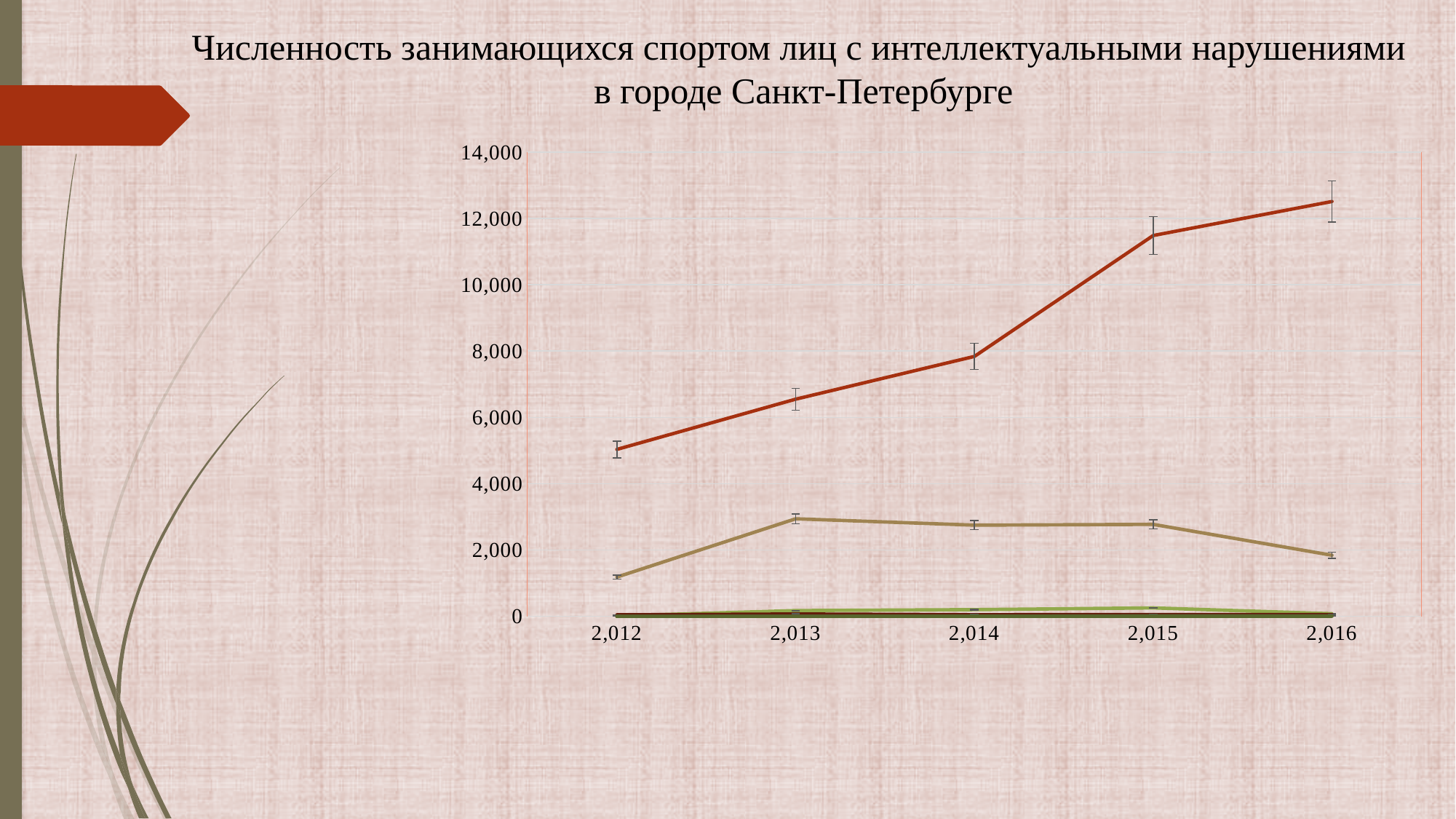
Is the value of the red line in 2,016 greater or less than 12,000? greater Which line is higher in 2,016, the red line or the tan line? the red line Is the value of the red line in 2,012 greater or less than 4,000? greater What is the last year shown on the x axis? 2,016 In which year does the tan line have its lowest value? 2,012 What is the first year shown on the x axis? 2,012 In which year does the red line have its lowest value? 2,012 In which year does the red line reach its highest value? 2,016 Does the red line rise or fall from 2,012 to 2,016? rises How many years are shown along the x axis of the chart? 5 What kind of chart is shown on the slide? line chart